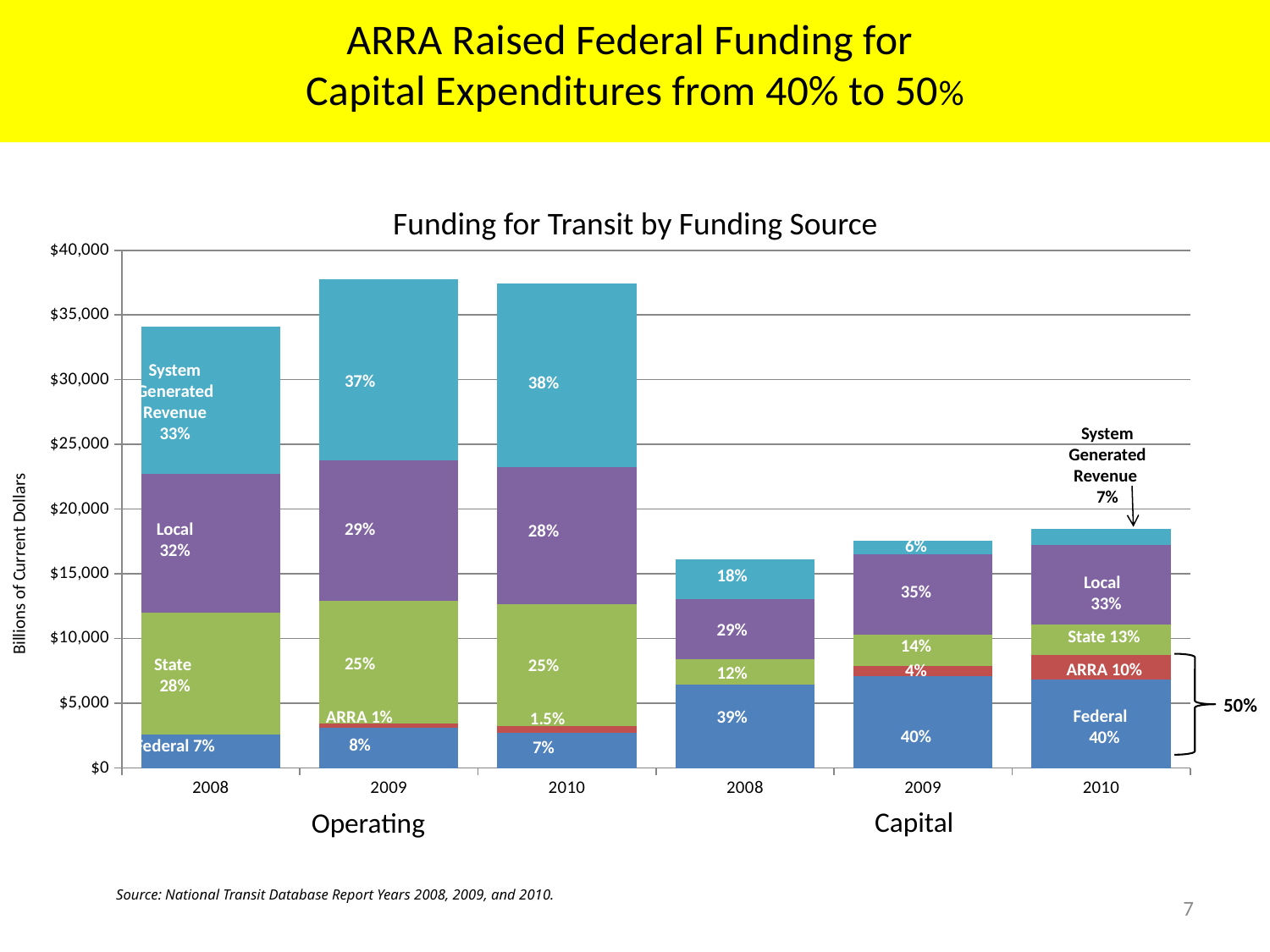
What percentage of Operating funding in 2008 came from System Generated Revenue? 33% What is the combined share of Federal and ARRA funding for Capital in 2010? 50% What percentage of Capital funding in 2009 came from Federal sources? 40% Which bar is the shortest in the chart? Capital 2008 What percentage of Operating funding in 2010 came from ARRA? 1.5% What kind of chart is shown on the slide? Stacked bar chart How many percentage points higher is the Federal share of Capital funding in 2010 (40%) than the Federal share of Operating funding in 2010 (7%)? 33 percentage points Is the total for Operating 2009 greater or less than $35,000? greater Which is larger, the total for Operating 2008 or the total for Capital 2008? Operating 2008 How many bars are plotted in the chart? 6 What is the title of the chart on the slide? Funding for Transit by Funding Source What percentage of Capital funding in 2010 came from ARRA? 10%